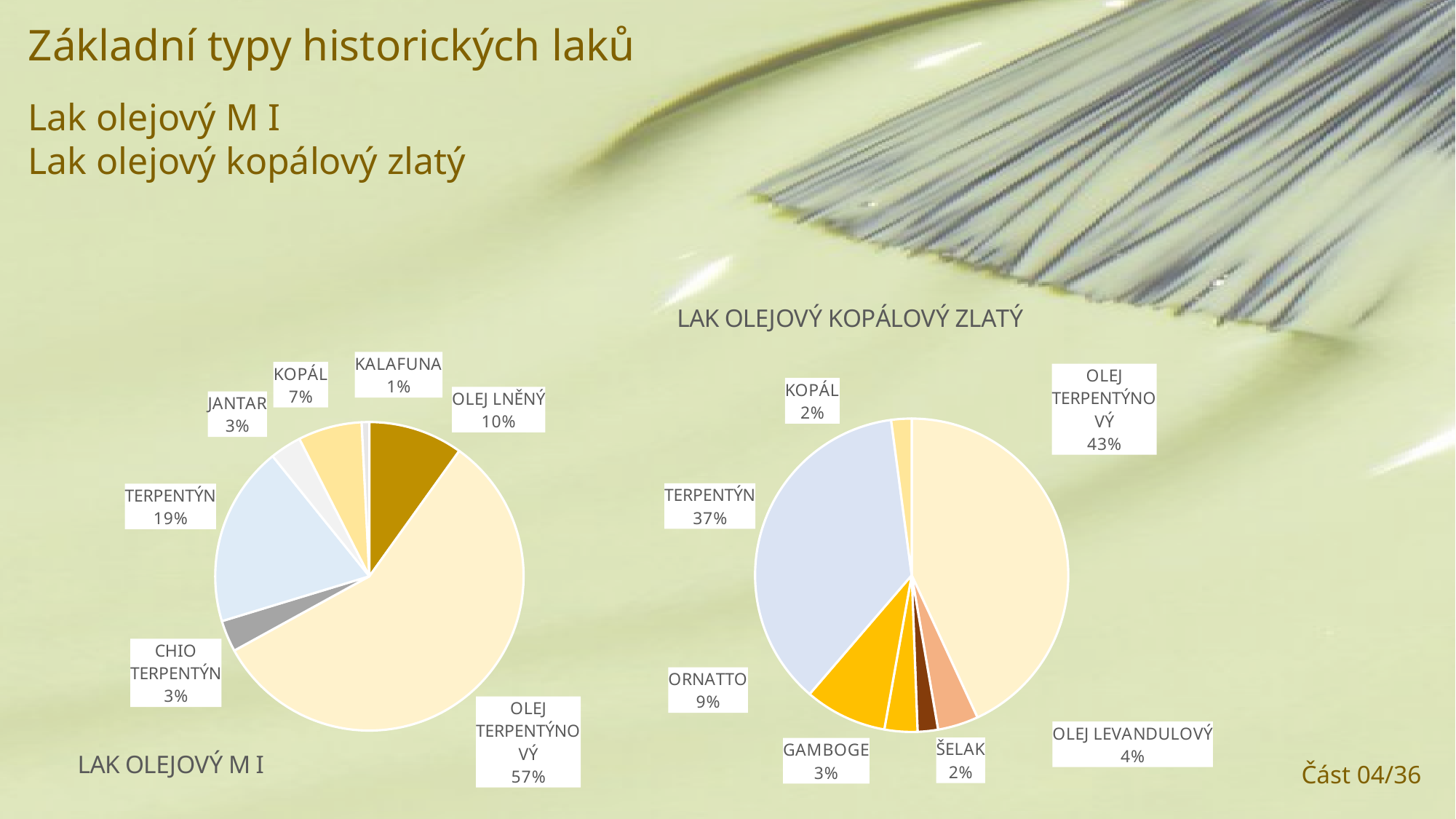
In the LAK OLEJOVÝ M I chart, what share does OLEJ TERPENTÝNOVÝ have? 57% In the LAK OLEJOVÝ KOPÁLOVÝ ZLATÝ chart, what is the value for ORNATTO? 9% In the LAK OLEJOVÝ M I chart, what is the difference between OLEJ LNĚNÝ and KOPÁL? 3% What type of chart is used for LAK OLEJOVÝ M I? Pie chart What is the title of the chart on the right side of the slide? LAK OLEJOVÝ KOPÁLOVÝ ZLATÝ In the LAK OLEJOVÝ M I chart, which ingredient has the smallest share? KALAFUNA In the LAK OLEJOVÝ M I chart, how many slices does the pie have? 7 In the LAK OLEJOVÝ KOPÁLOVÝ ZLATÝ chart, which ingredient has the largest share? OLEJ TERPENTÝNOVÝ In the LAK OLEJOVÝ M I chart, what is the value for TERPENTÝN? 19% In the LAK OLEJOVÝ KOPÁLOVÝ ZLATÝ chart, what is the difference between OLEJ TERPENTÝNOVÝ and TERPENTÝN? 6% In the LAK OLEJOVÝ KOPÁLOVÝ ZLATÝ chart, which is larger, OLEJ LEVANDULOVÝ or GAMBOGE? OLEJ LEVANDULOVÝ In the LAK OLEJOVÝ KOPÁLOVÝ ZLATÝ chart, what share does TERPENTÝN have? 37%